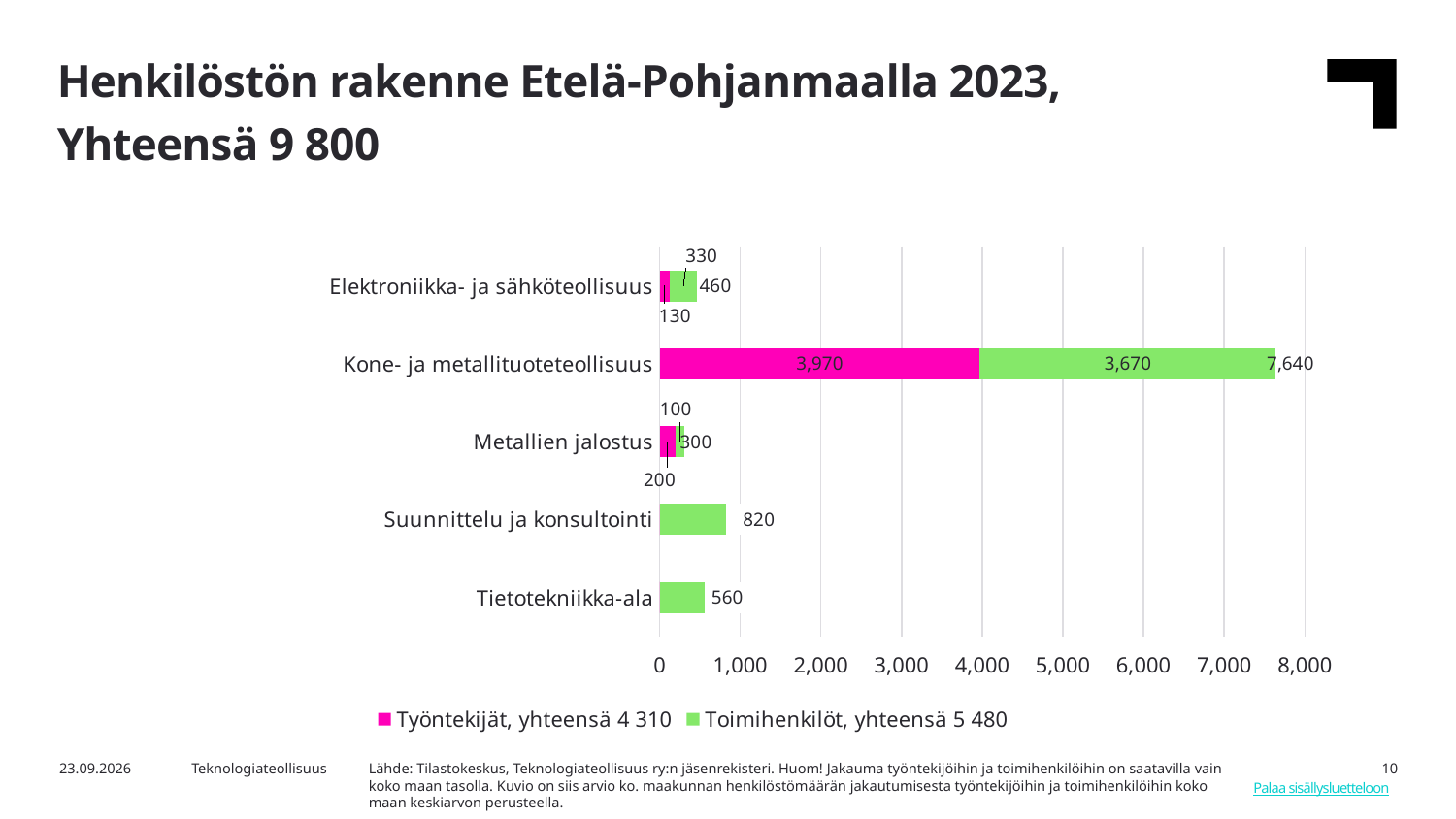
What is the Toimihenkilöt value for Elektroniikka- ja sähköteollisuus? 330 What is the Toimihenkilöt value for Suunnittelu ja konsultointi? 820 What total is given for Toimihenkilöt in the legend? 5 480 What is the Toimihenkilöt value for Kone- ja metallituoteteollisuus? 3,670 What kind of chart is shown on the slide? Stacked bar chart Which category has the highest total? Kone- ja metallituoteteollisuus How many series does the legend list? 2 How many categories are shown on the chart? 5 Which is larger for Kone- ja metallituoteteollisuus, the Työntekijät value or the Toimihenkilöt value? Työntekijät What is the Työntekijät value for Kone- ja metallituoteteollisuus? 3,970 What is the total shown for the Kone- ja metallituoteteollisuus bar? 7,640 What is the difference between the Toimihenkilöt values for Suunnittelu ja konsultointi and Tietotekniikka-ala? 260